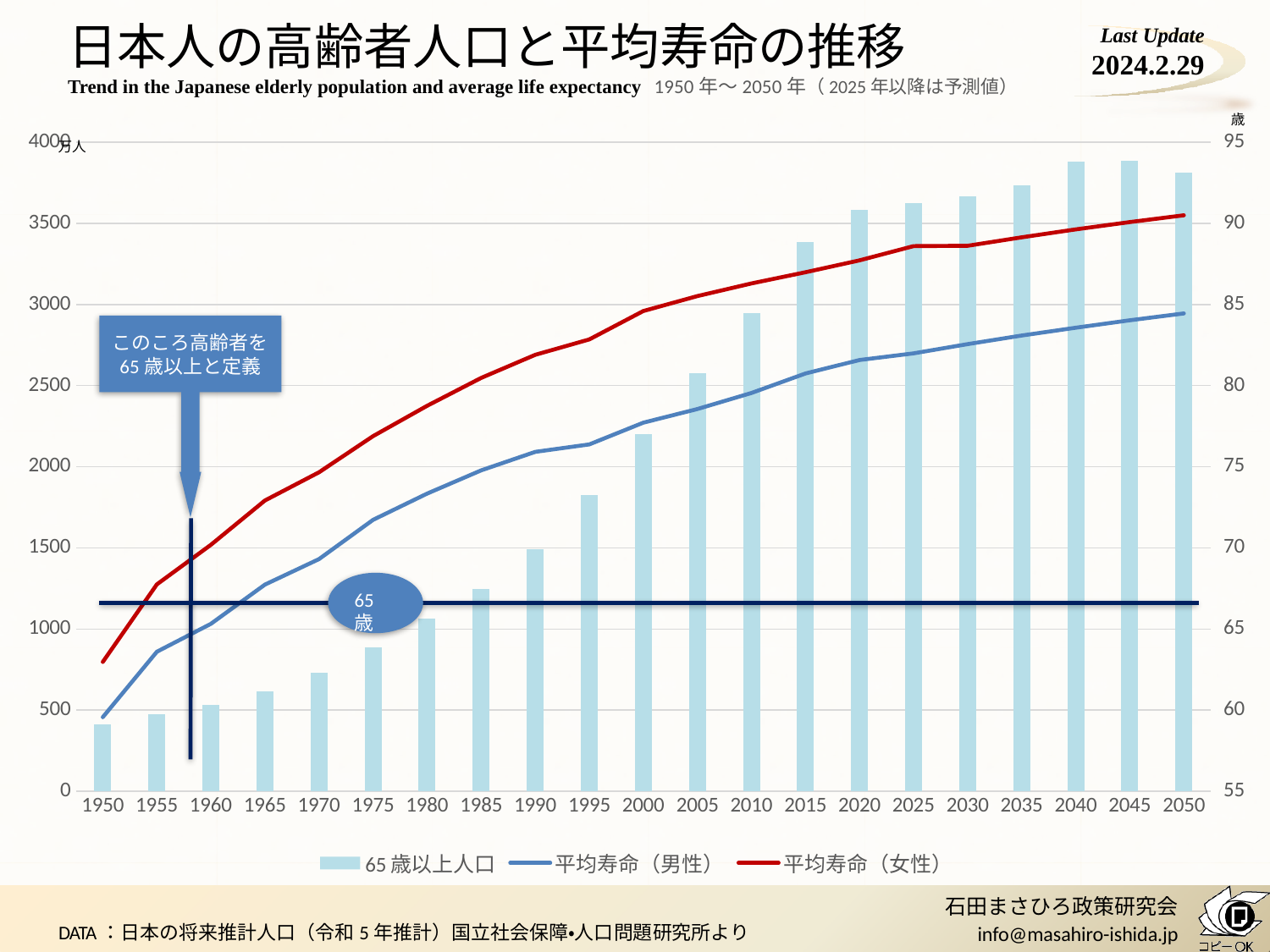
Does the 平均寿命（男性） line rise or fall from 1950 to 2050? rise Is the 平均寿命（女性） value for 1950 greater or less than 65 on the right axis? less Is the 65歳以上人口 bar for 2050 greater or less than 3500? greater Which is higher in 2050, the 平均寿命（男性） line or the 平均寿命（女性） line? 平均寿命（女性） What colour is the 平均寿命（女性） line? Red How many series does the legend list? 3 What kind of chart is shown on the slide? A combined bar and line chart How many years are shown along the x axis? 21 Which year has the lowest bar for 65歳以上人口? 1950 Is the 65歳以上人口 bar for 2015 greater or less than 3000? greater